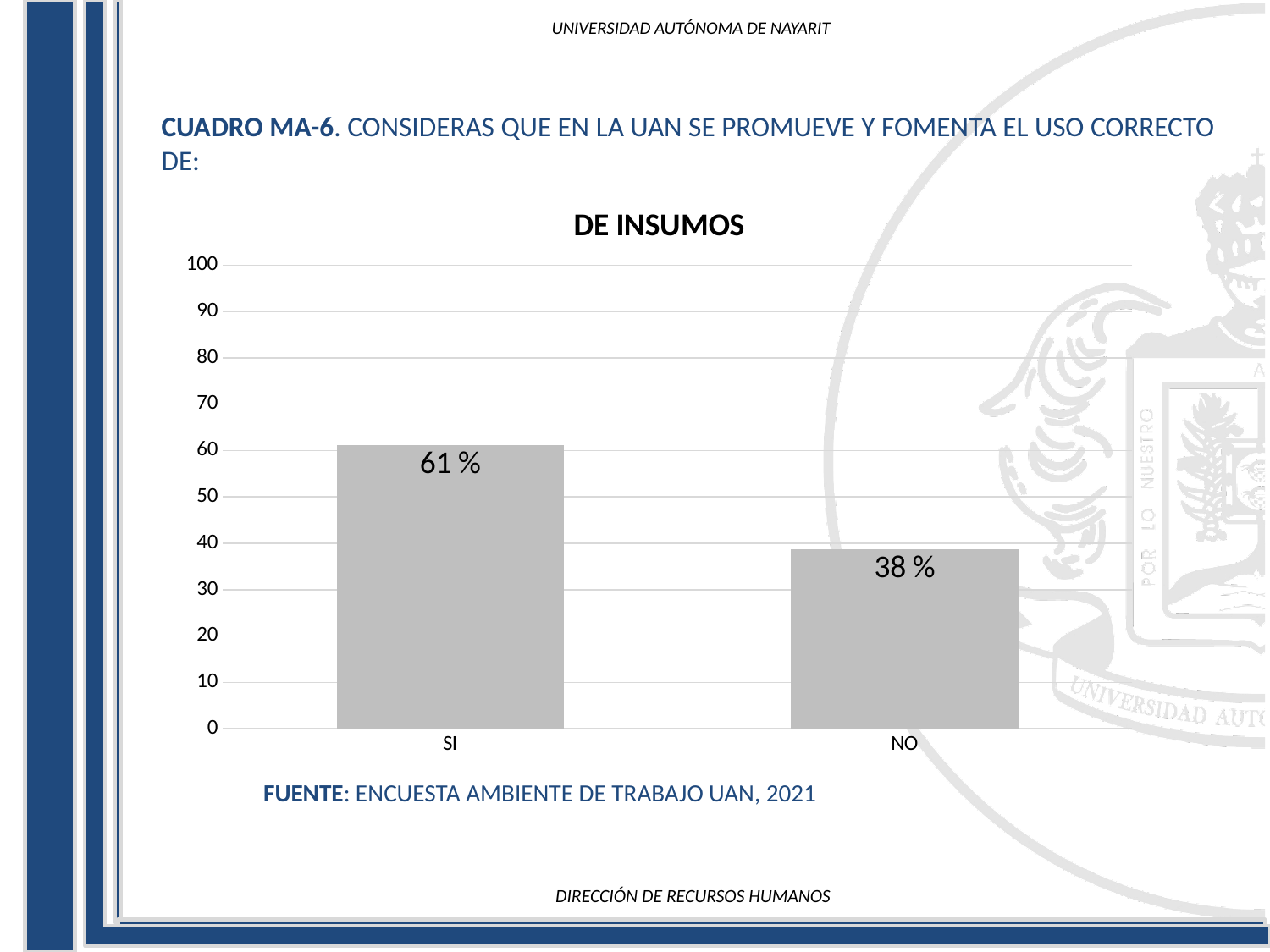
How many categories are shown in the chart? 2 Which category has the lowest value? NO What is the value for NO? 38 % Is the value for NO greater or less than 40? less Which is larger, the value for SI or the value for NO? SI Is the value for SI greater or less than 50? greater What is the title of the chart? DE INSUMOS What is the highest value shown on the vertical axis? 100 What is the value for SI? 61 % What is the difference between the values for SI and NO? 23 % What kind of chart is shown on the slide? bar chart Which category has the highest value? SI